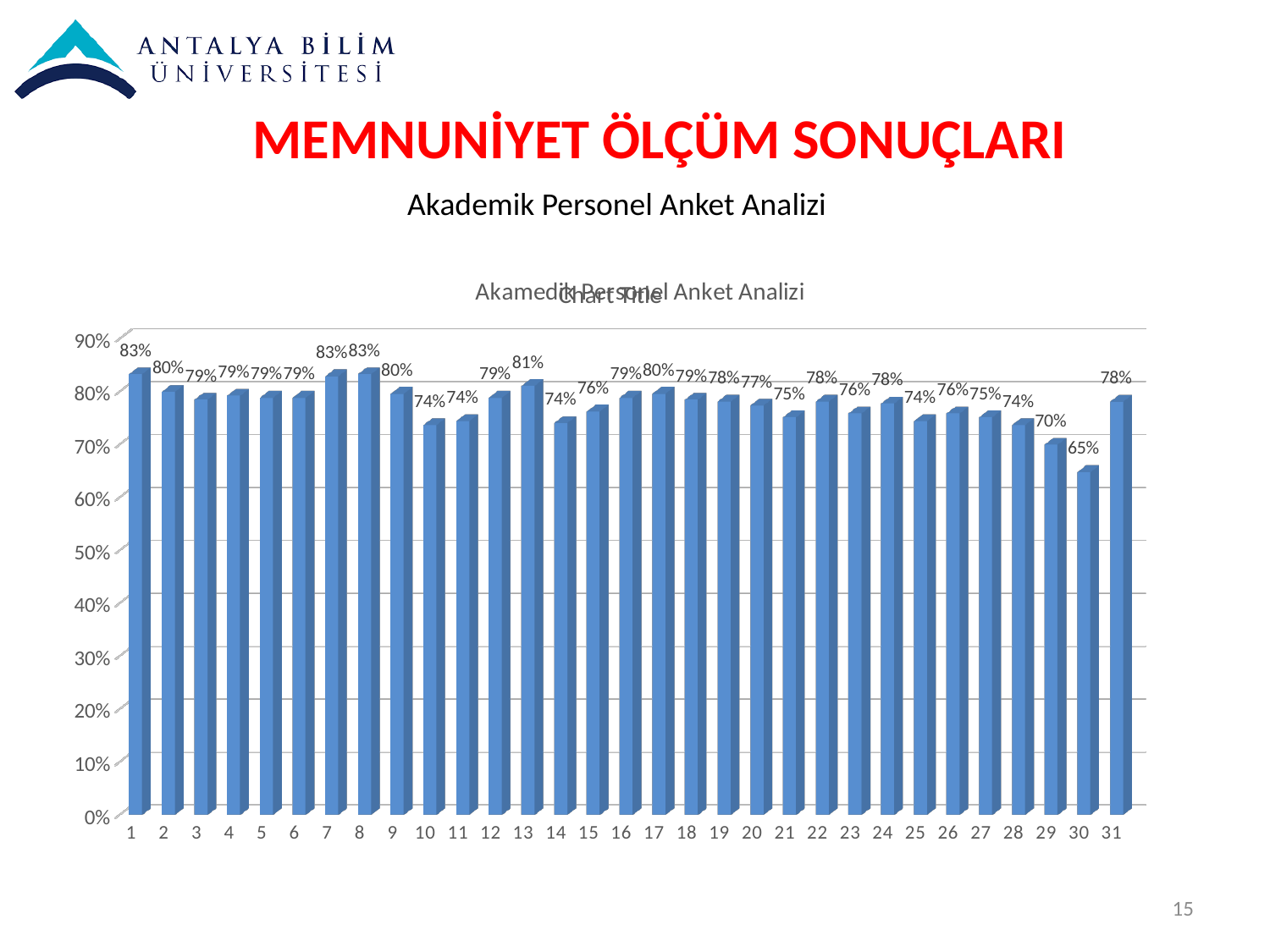
What is the difference between the values for category 13 and category 14? 7% What is the value for category 31? 78% What is the difference between the values for category 1 and category 30? 18% What is the value for category 1? 83% Which is larger, the value for category 9 or the value for category 10? category 9 What is the value for category 13? 81% Is the value for category 30 greater or less than 70%? less What is the value for category 29? 70% Which is larger, the value for category 29 or the value for category 30? category 29 Which category has the lowest value? 30 What kind of chart is shown on the slide? bar chart How many categories are shown on the x axis? 31